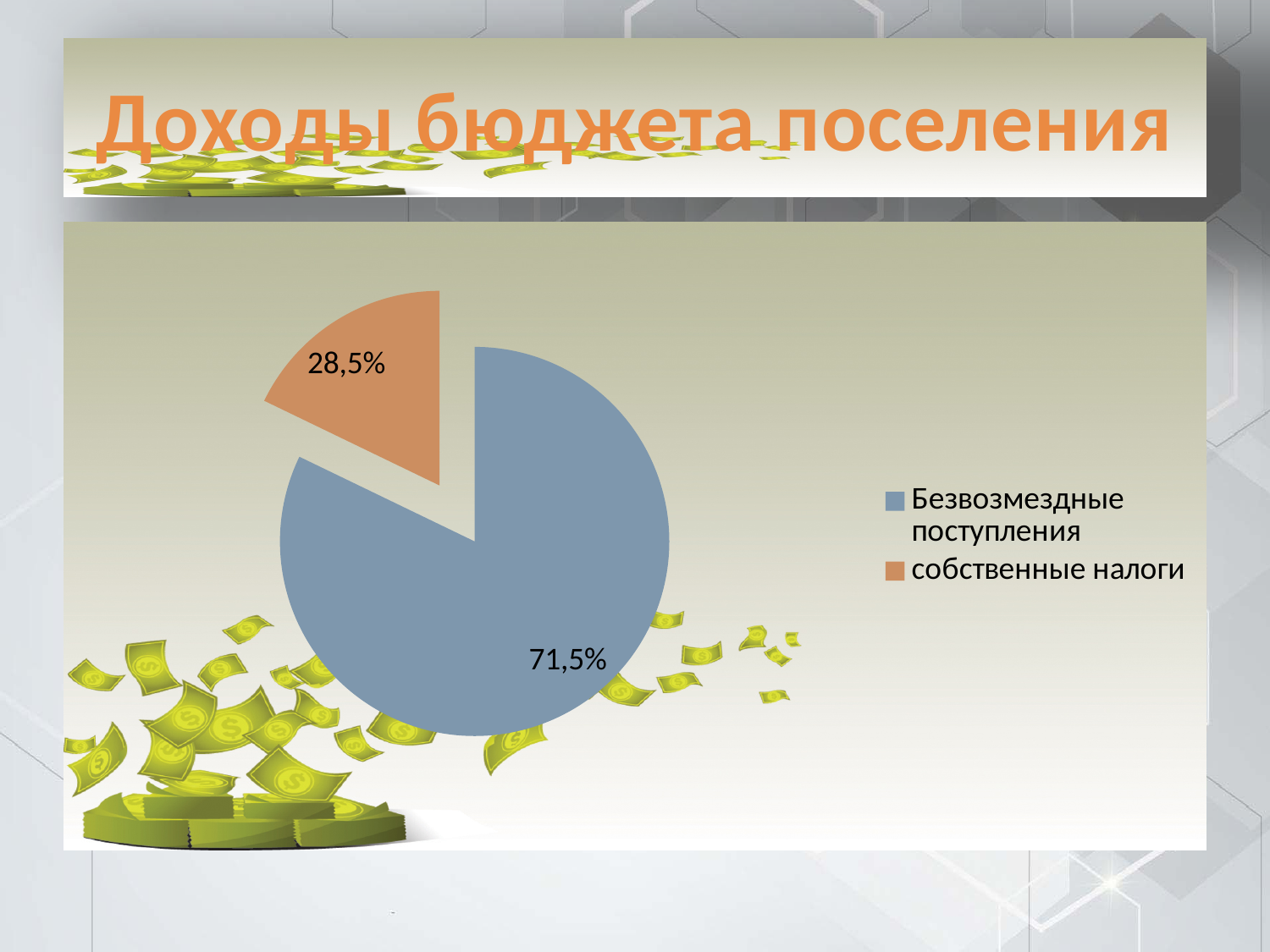
What is the value for Безвозмездные поступления? 71,5% Which is larger, Безвозмездные поступления or собственные налоги? Безвозмездные поступления What kind of chart is shown on the slide? pie chart What is the difference between the shares of Безвозмездные поступления and собственные налоги? 43% Which category has the smallest share of the pie? собственные налоги What is the title of the slide containing the chart? Доходы бюджета поселения Which category has the largest share of the pie? Безвозмездные поступления What is the value for собственные налоги? 28,5% How many entries does the legend list? 2 What colour is the slice for собственные налоги? orange How many slices does the pie chart have? 2